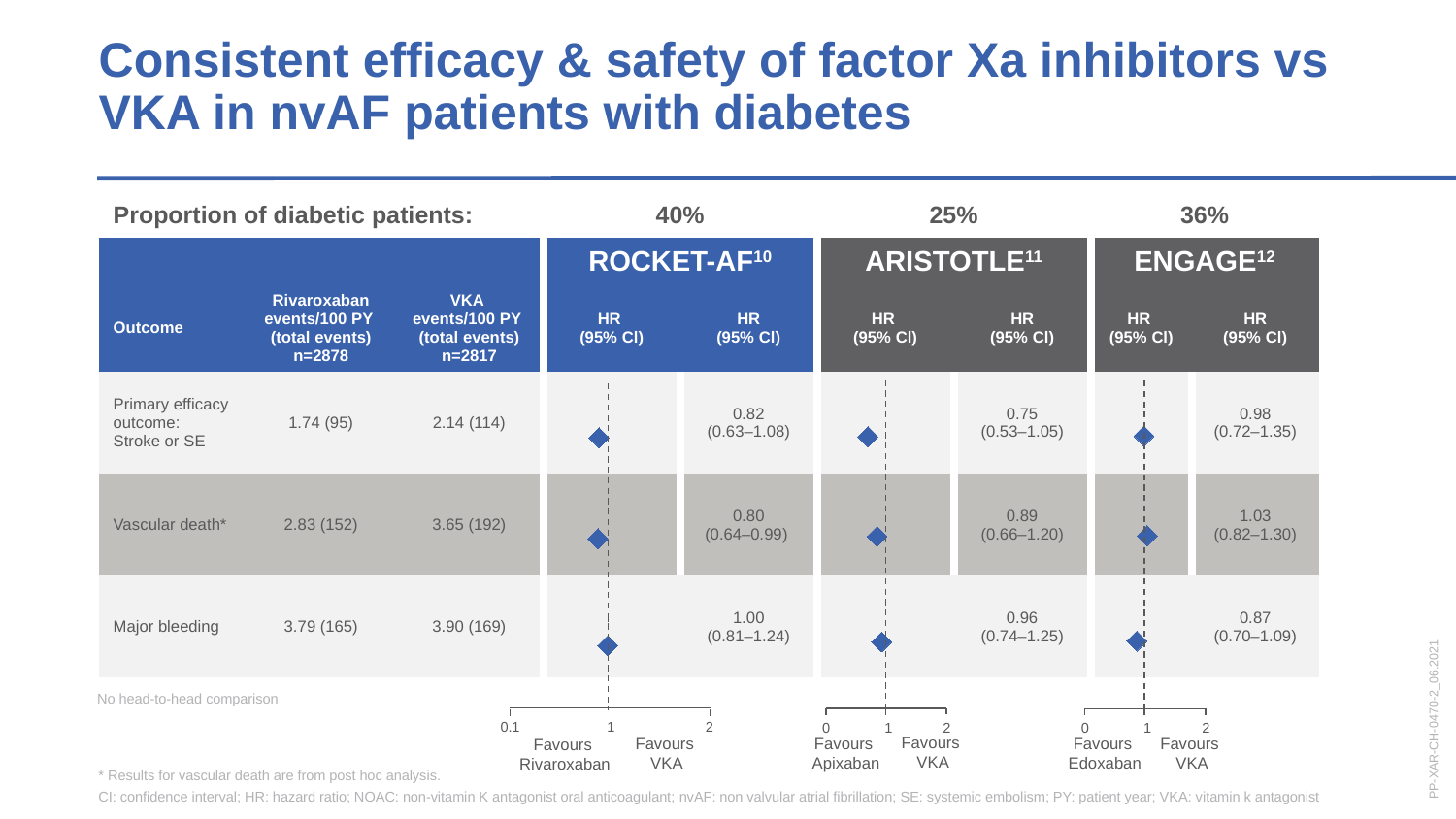
For vascular death, is the hazard ratio larger in the ROCKET-AF plot or the ENGAGE plot? ENGAGE How many outcomes are plotted in each forest plot? 3 In the ROCKET-AF forest plot, what is the 95% CI for major bleeding? 0.81–1.24 In the ROCKET-AF forest plot, what is the hazard ratio for the primary efficacy outcome (stroke or SE)? 0.82 What kind of chart is used to display the hazard ratios on this slide? Forest plot In the ROCKET-AF forest plot, is the hazard ratio for vascular death greater or less than 1? less What proportion of diabetic patients is shown above the ROCKET-AF forest plot? 40% In the ENGAGE forest plot, what is the hazard ratio for major bleeding? 0.87 What is the difference between the ENGAGE and ARISTOTLE hazard ratios for the primary efficacy outcome? 0.23 Across the three forest plots, which trial shows the lowest hazard ratio for the primary efficacy outcome? ARISTOTLE In the ARISTOTLE forest plot, what is the hazard ratio for vascular death? 0.89 Across the three forest plots, which trial shows the highest hazard ratio for vascular death? ENGAGE